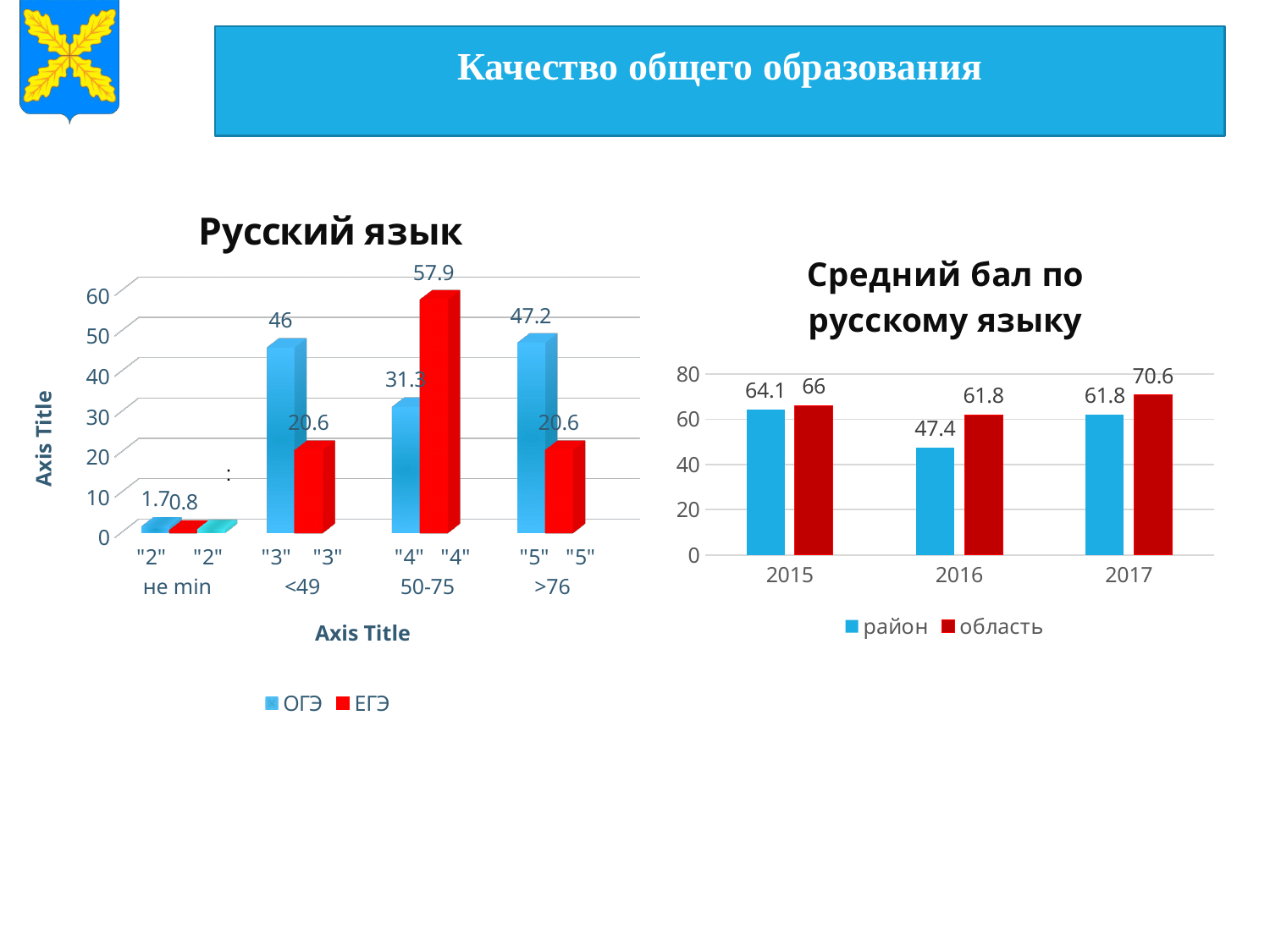
In the chart 'Русский язык', what is the ОГЭ value for the "5" >76 category? 47.2 In the chart 'Средний бал по русскому языку', what is the difference between область and район in 2016? 14.4 In the chart 'Средний бал по русскому языку', which year has the lowest value for район? 2016 In the chart 'Русский язык', what is the ЕГЭ value for the "4" 50-75 category? 57.9 In the chart 'Русский язык', what is the difference between the ЕГЭ and ОГЭ values for the "4" 50-75 category? 26.6 What type of chart is 'Русский язык'? bar chart In the chart 'Русский язык', which is larger for the "3" <49 category, ОГЭ or ЕГЭ? ОГЭ In the chart 'Средний бал по русскому языку', what is the value for район in 2016? 47.4 In the chart 'Средний бал по русскому языку', which year has the highest value for область? 2017 In the chart 'Средний бал по русскому языку', what is the value for область in 2017? 70.6 In the chart 'Средний бал по русскому языку', how many series does the legend list? 2 In the chart 'Средний бал по русскому языку', does the район value rise or fall from 2016 to 2017? rise